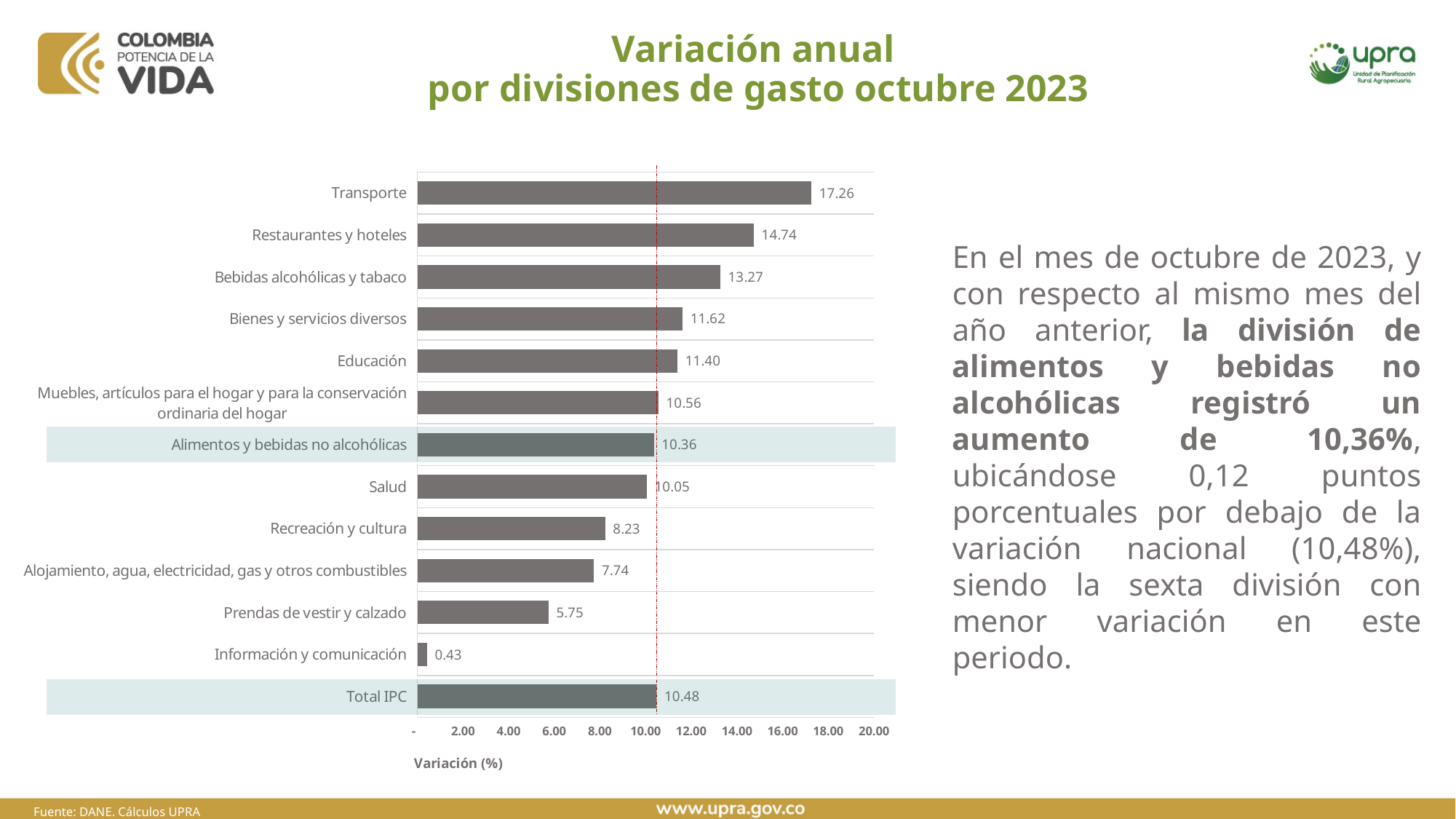
Which category has the highest value? Transporte Which is larger, the value for Educación or the value for Recreación y cultura? Educación What is the title of the horizontal axis? Variación (%) What is the value for Transporte? 17.26 What is the difference between the values for Transporte and Restaurantes y hoteles? 2.52 What is the value for Prendas de vestir y calzado? 5.75 Which category has the lowest value? Información y comunicación What is the difference between the values for Total IPC and Alimentos y bebidas no alcohólicas? 0.12 How many bars are shown in the chart? 13 What is the value for Alimentos y bebidas no alcohólicas? 10.36 What kind of chart is shown on the slide? Bar chart What is the value for Total IPC? 10.48